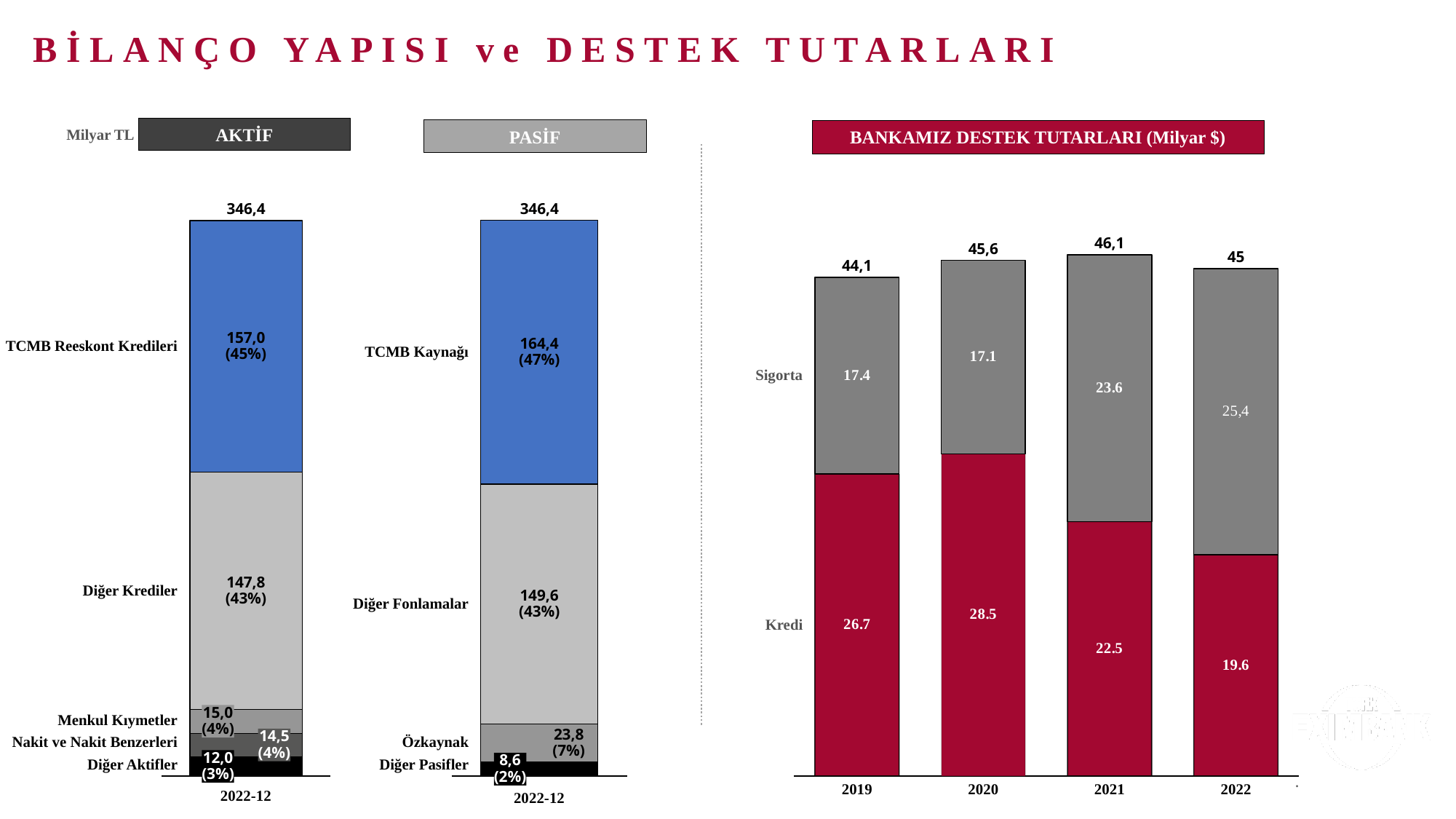
In the PASİF chart, which segment is the largest? TCMB Kaynağı In the AKTİF chart, what is the total of the stacked bar for 2022-12? 346,4 In the BANKAMIZ DESTEK TUTARLARI chart, is the Kredi value for 2019 larger or smaller than the Sigorta value for 2019? larger In the PASİF chart, what is the value for Özkaynak? 23,8 In the BANKAMIZ DESTEK TUTARLARI chart, what is the Sigorta value for 2022? 25,4 What kind of chart is the BANKAMIZ DESTEK TUTARLARI chart? stacked bar chart In the AKTİF chart, what is the value for TCMB Reeskont Kredileri? 157,0 In the PASİF chart, which segment is the smallest? Diğer Pasifler In the AKTİF chart, what percentage share is shown for Diğer Krediler? 43% In the BANKAMIZ DESTEK TUTARLARI chart, which year has the highest total? 2021 In the BANKAMIZ DESTEK TUTARLARI chart, how many years are shown on the x axis? 4 In the BANKAMIZ DESTEK TUTARLARI chart, what is the Kredi value for 2020? 28.5